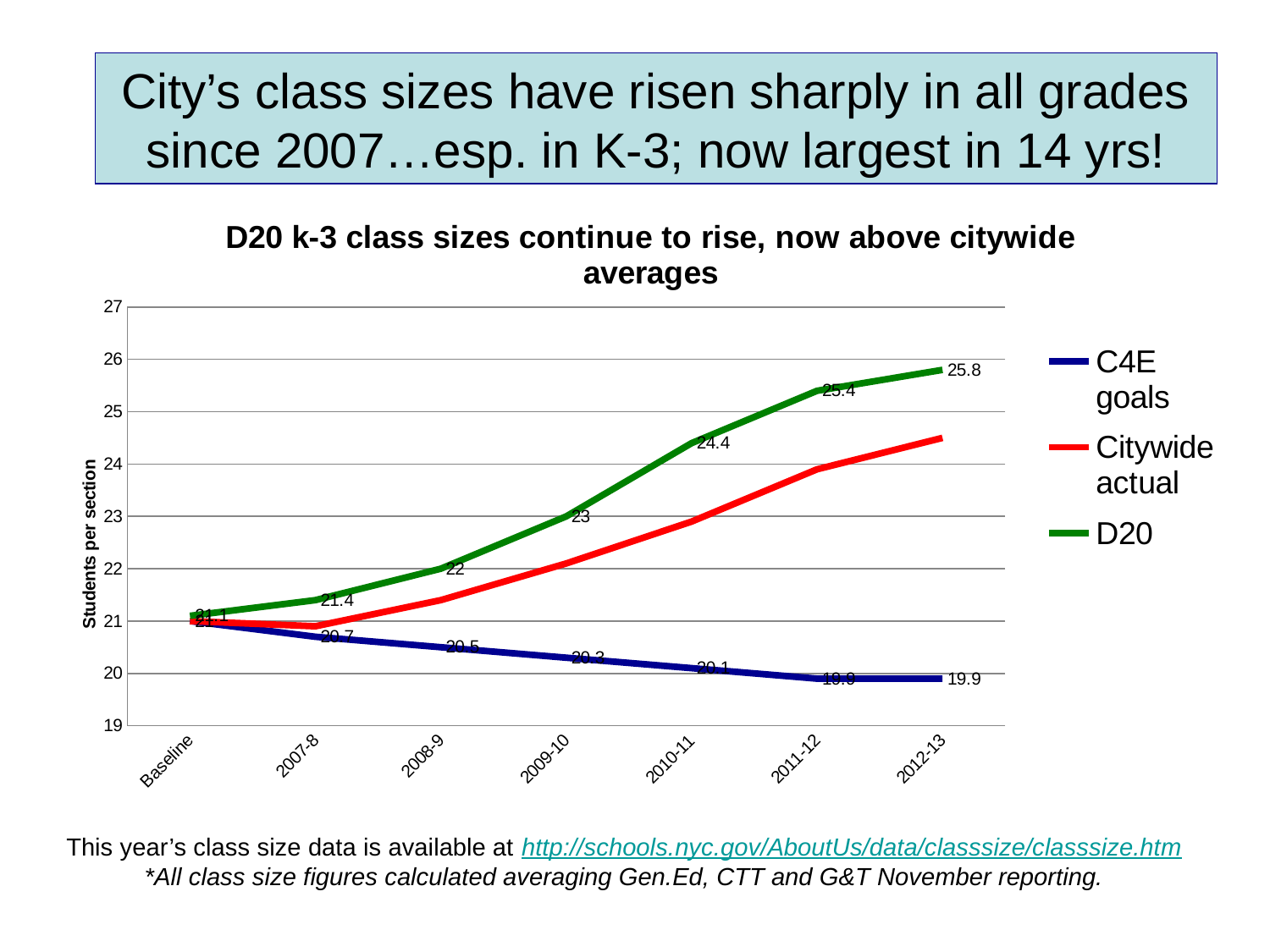
How many points are shown along the x axis? 7 Which series has the highest value in 2012-13? D20 What is the D20 value for 2012-13? 25.8 What is the D20 value for 2008-9? 22 What is the difference between the D20 value and the C4E goals value in 2012-13? 5.9 What is the title of the y axis? Students per section Is the Citywide actual value for 2012-13 greater or less than 24? greater Does the D20 series rise or fall from Baseline to 2012-13? rises How many series does the legend list? 3 What kind of chart is shown on the slide? line chart What is the C4E goals value for 2012-13? 19.9 What is the D20 value for 2009-10? 23